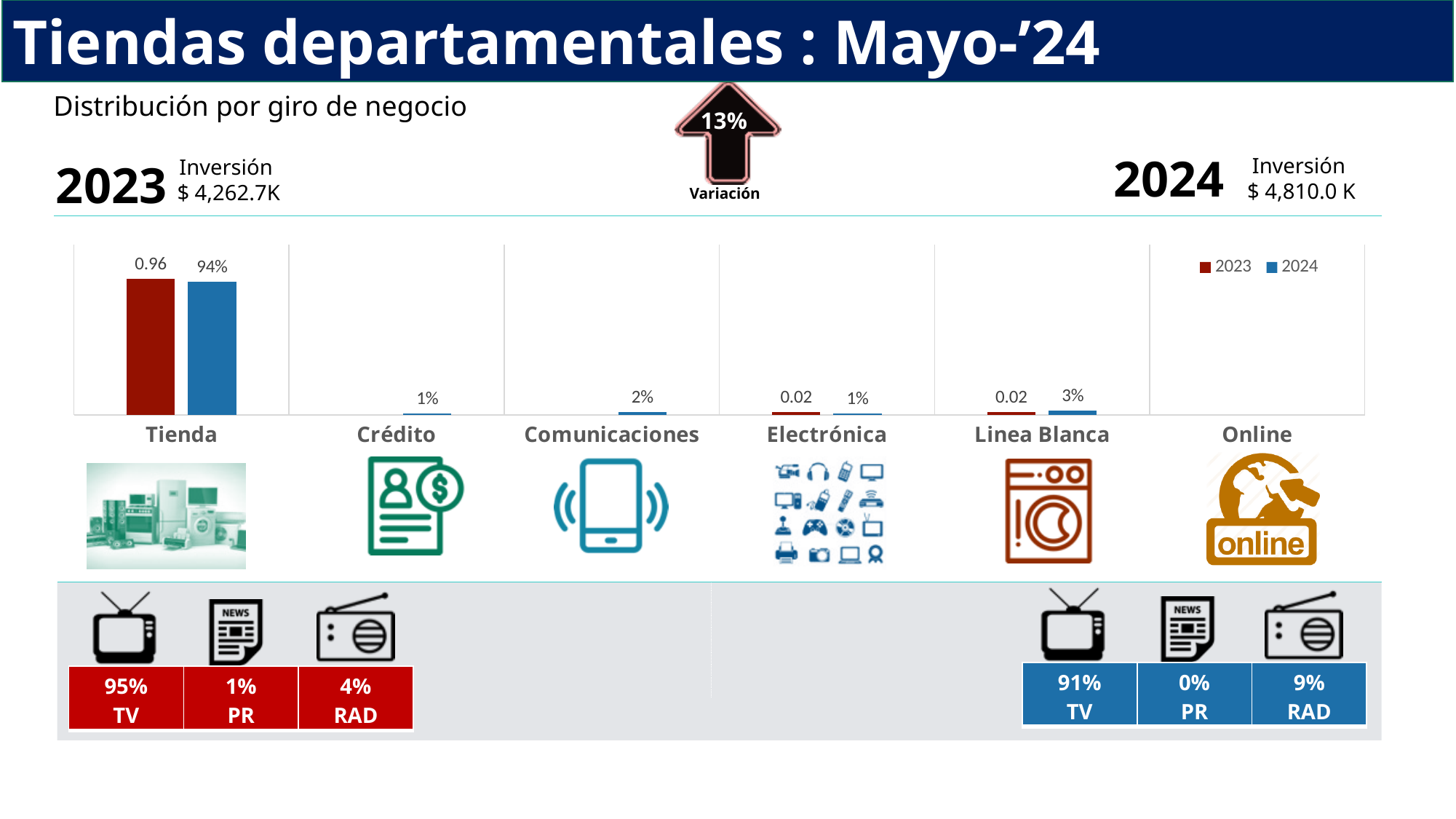
How many categories are shown along the x axis of the chart? 6 What kind of chart is shown on the slide? bar chart Which is larger, the 2024 value for Linea Blanca or the 2024 value for Crédito? Linea Blanca What is the 2024 value for Crédito? 1% What is the 2023 value for Tienda? 0.96 What is the 2023 value for Electrónica? 0.02 How many series does the chart legend list? 2 What is the 2024 value for Linea Blanca? 3% What are the two series named in the chart legend? 2023 and 2024 Which category has the highest 2024 value? Tienda What is the 2024 value for Tienda? 94% What is the 2024 value for Comunicaciones? 2%